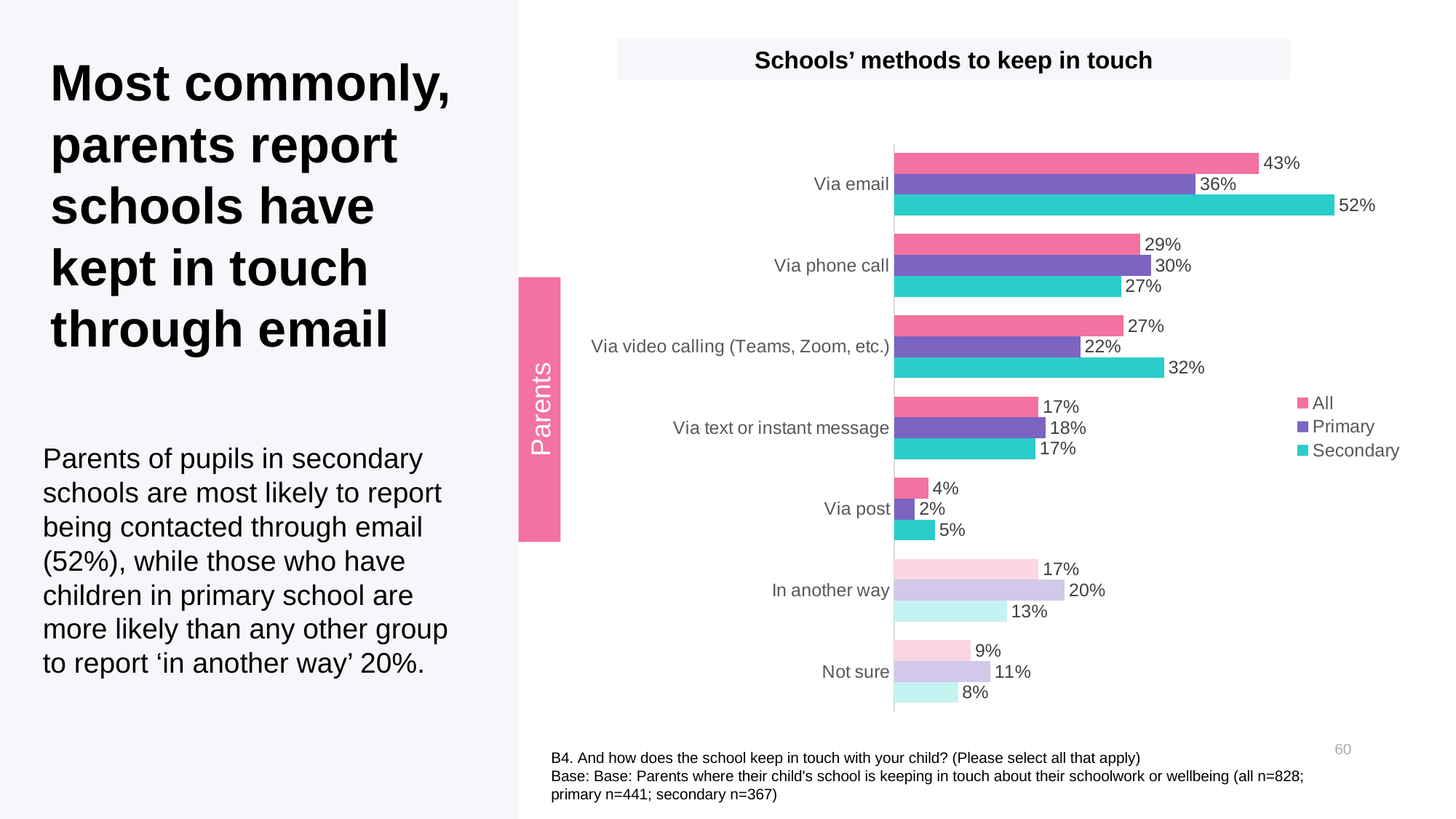
Which method has the lowest value for the Primary series? Via post What is the title of the chart? Schools' methods to keep in touch How many series does the legend list? 3 What is the value for All for 'Via post'? 4% What is the difference between the Primary and Secondary values for 'In another way'? 7% What is the difference between the Secondary and Primary values for 'Via email'? 16% Which method has the highest value for the Secondary series? Via email What is the value for Primary for 'Via phone call'? 30% How many methods (categories) are shown on the chart? 7 What percentage of Secondary parents report the school keeps in touch via email? 52% What kind of chart is shown on the slide? Bar chart For 'Via video calling (Teams, Zoom, etc.)', which is larger: the Primary value or the Secondary value? Secondary